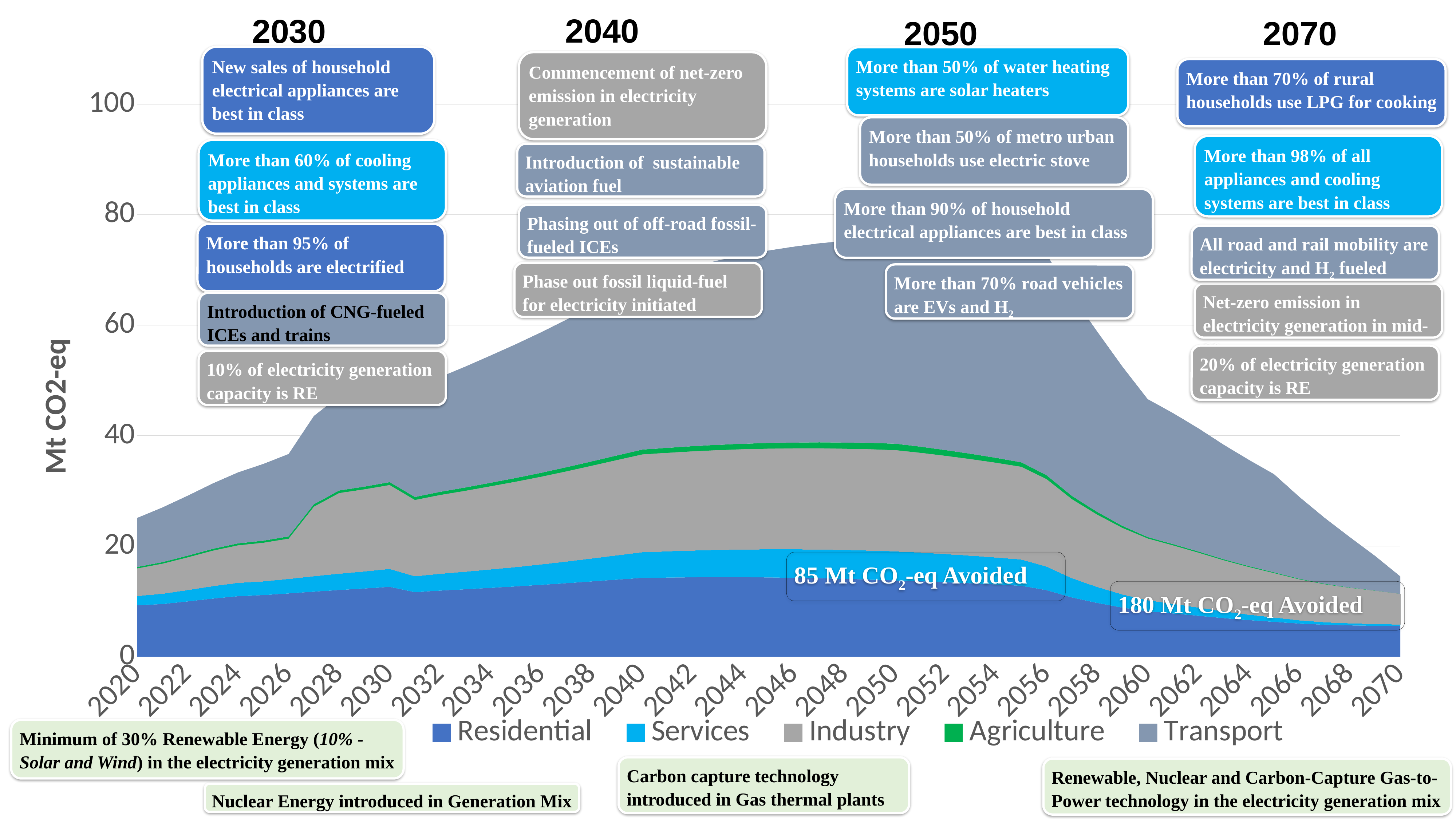
What is the label on the chart's vertical axis? Mt CO2-eq Does the total stacked value rise or fall between 2020 and 2050? rise How many series does the chart's legend list? 5 How many year labels are shown along the x axis of the chart? 26 Is the total stacked value in 2070 greater or less than 20 Mt CO2-eq? less Is the total stacked value in 2020 greater or less than 40 Mt CO2-eq? less Which series forms the top layer of the stacked area chart? Transport Does the total stacked value rise or fall between 2050 and 2070? fall What kind of chart is shown on the slide? Stacked area chart Is the total stacked value in 2050 greater or less than 60 Mt CO2-eq? greater Which series are listed in the chart's legend? Residential, Services, Industry, Agriculture, Transport